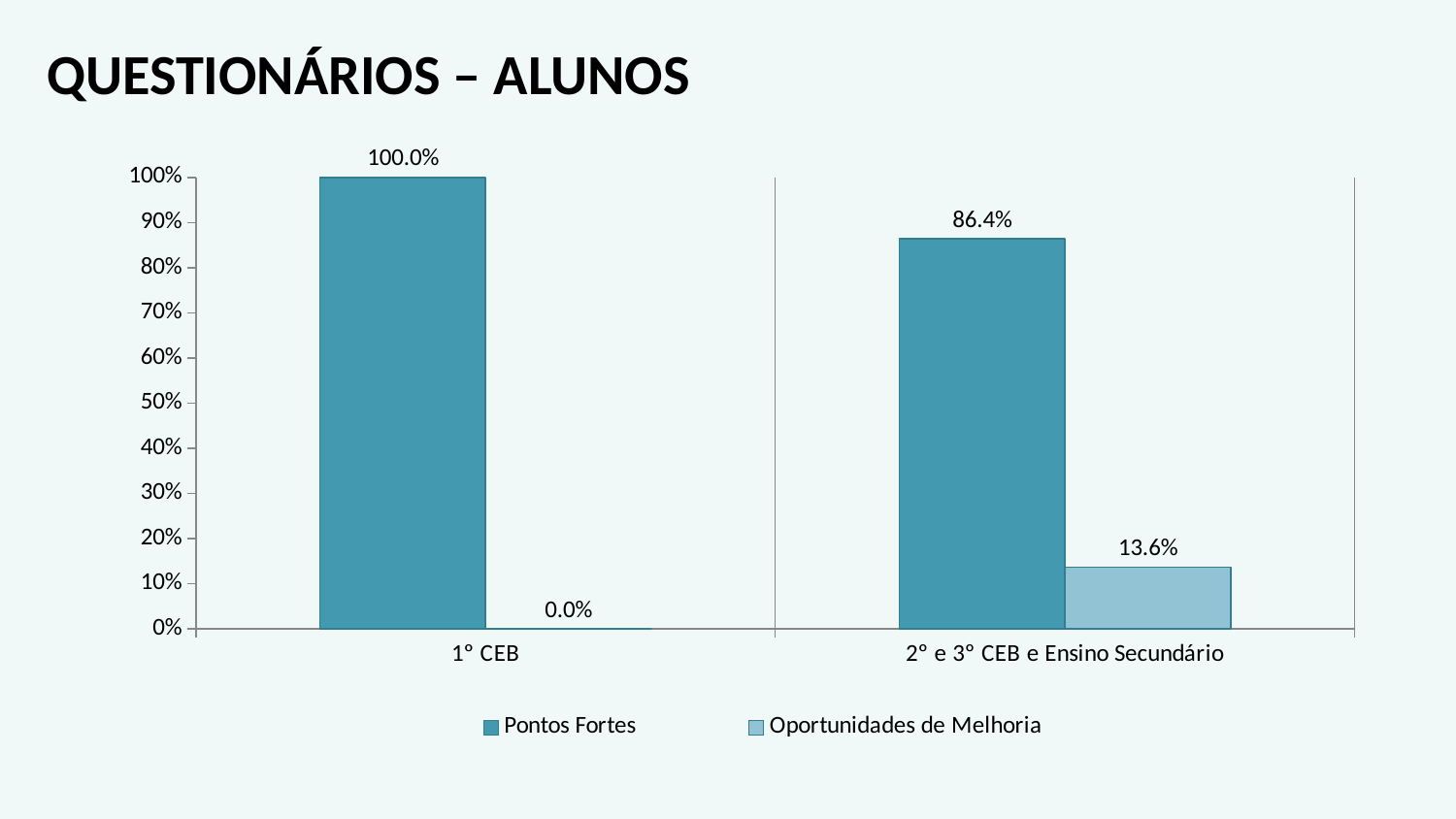
What is the difference between Pontos Fortes and Oportunidades de Melhoria for 2° e 3° CEB e Ensino Secundário? 72.8% Which category has the lowest value for Oportunidades de Melhoria? 1° CEB Which category has the highest value for Pontos Fortes? 1° CEB What is the value of Pontos Fortes for 2° e 3° CEB e Ensino Secundário? 86.4% How many series does the legend list? 2 What is the title of the slide? QUESTIONÁRIOS – ALUNOS Which is larger: Pontos Fortes for 1° CEB or Pontos Fortes for 2° e 3° CEB e Ensino Secundário? Pontos Fortes for 1° CEB What is the value of Oportunidades de Melhoria for 1° CEB? 0.0% What is the value of Oportunidades de Melhoria for 2° e 3° CEB e Ensino Secundário? 13.6% How many categories are shown on the x axis? 2 What is the value of Pontos Fortes for 1° CEB? 100.0% What kind of chart is shown on the slide? Bar chart